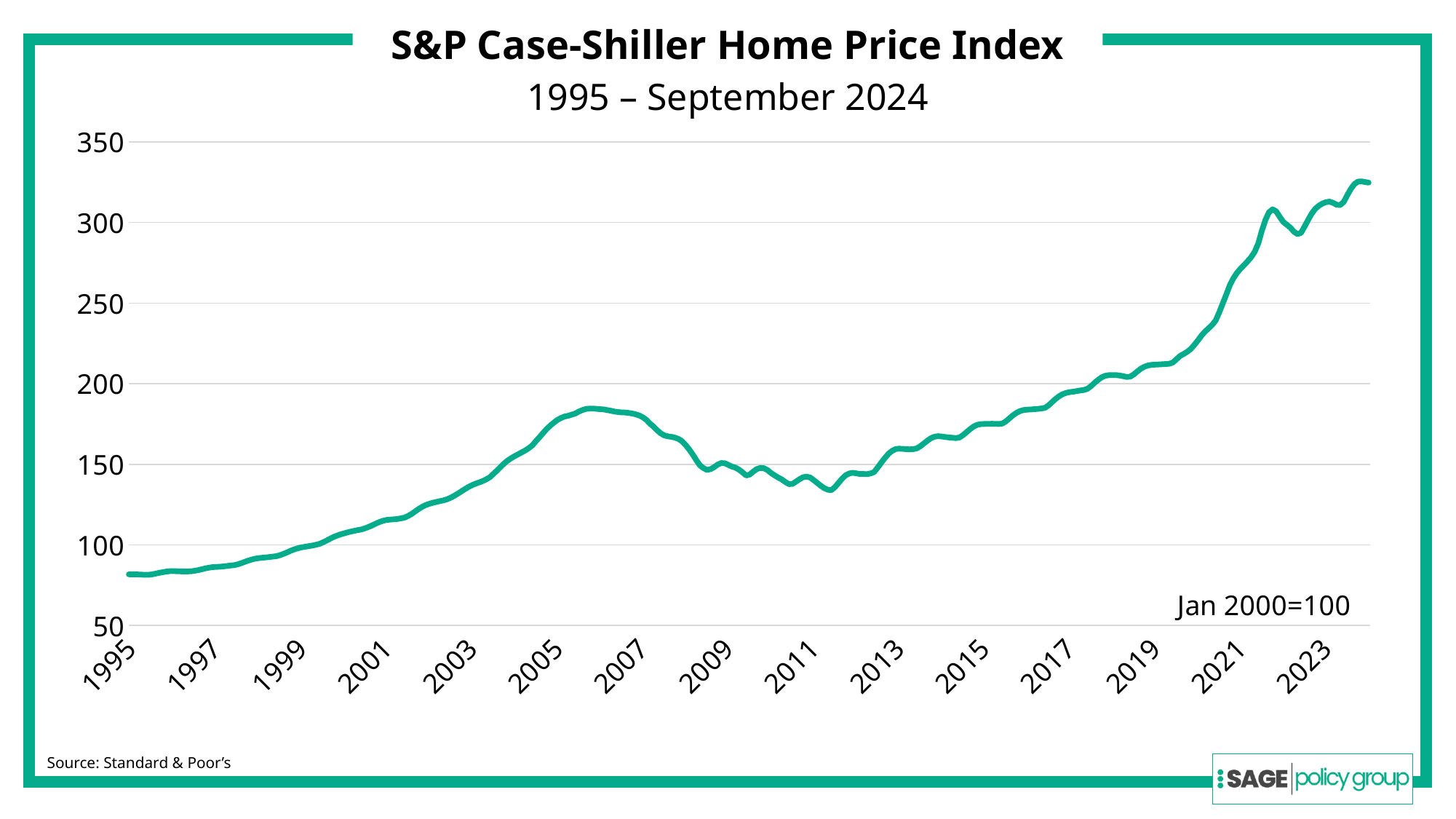
Is the value of the index at the start of 2011 greater or less than 150? less Does the index rise or fall between 2013 and 2023? rise Is the value of the index at the start of 2007 greater or less than 150? greater Is the value of the index at the start of 2015 greater or less than 200? less Does the index rise or fall between 2007 and 2011? fall What period does the chart's subtitle say it covers? 1995 – September 2024 What is the title of the chart? S&P Case-Shiller Home Price Index How many year labels are shown on the x axis? 15 What kind of chart is shown on the slide? line chart